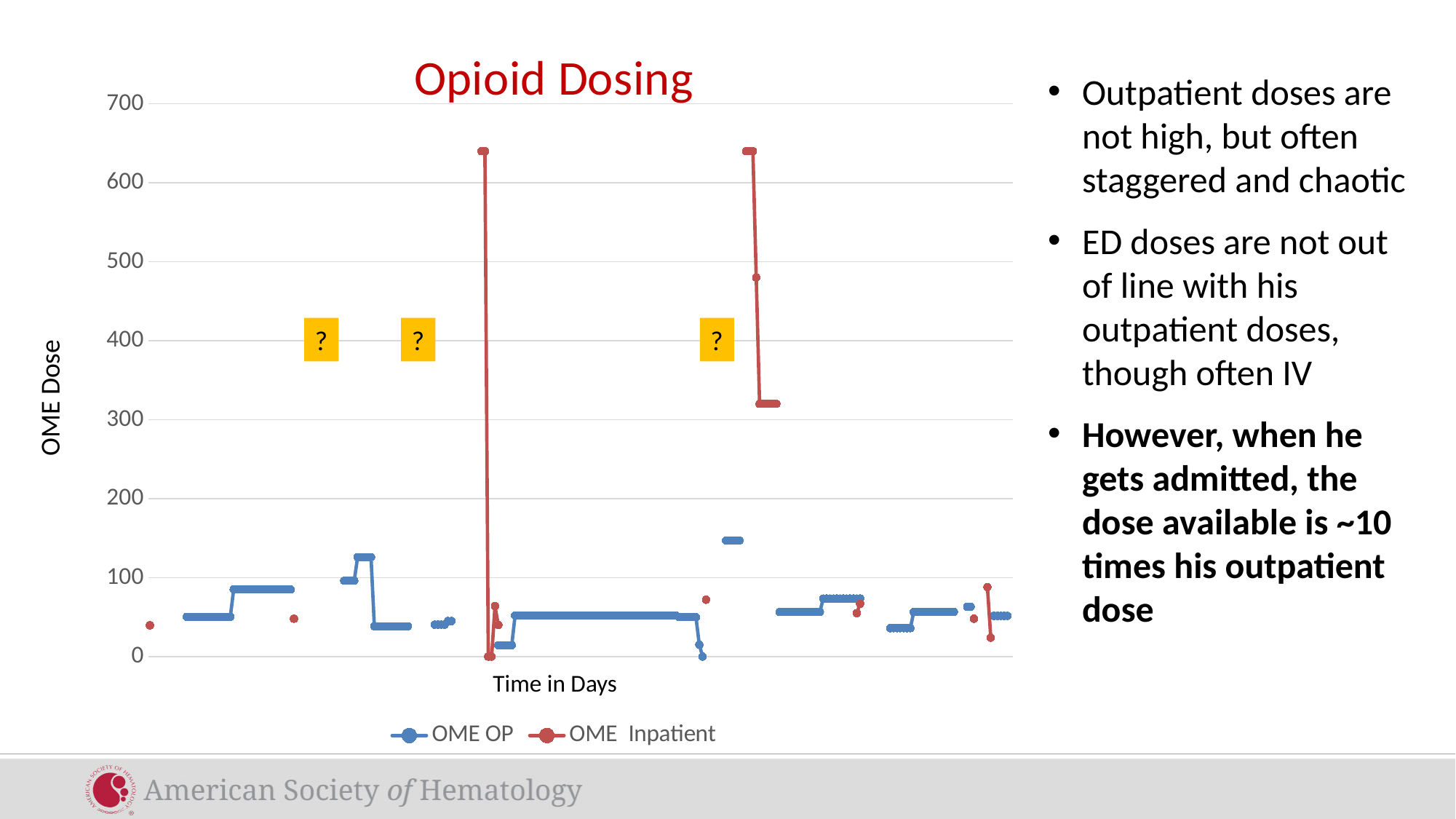
What kind of chart is shown on the slide? line chart Is the highest value reached by the OME Inpatient series greater or less than 600? greater Which series reaches the higher peak value, OME OP or OME Inpatient? OME Inpatient What are the two series named in the chart legend? OME OP and OME Inpatient What is the label on the vertical axis of the chart? OME Dose Is the highest value reached by the OME OP series greater or less than 200? less Is the highest value reached by the OME OP series greater or less than 100? greater What is the title of the chart? Opioid Dosing How many series does the chart legend list? 2